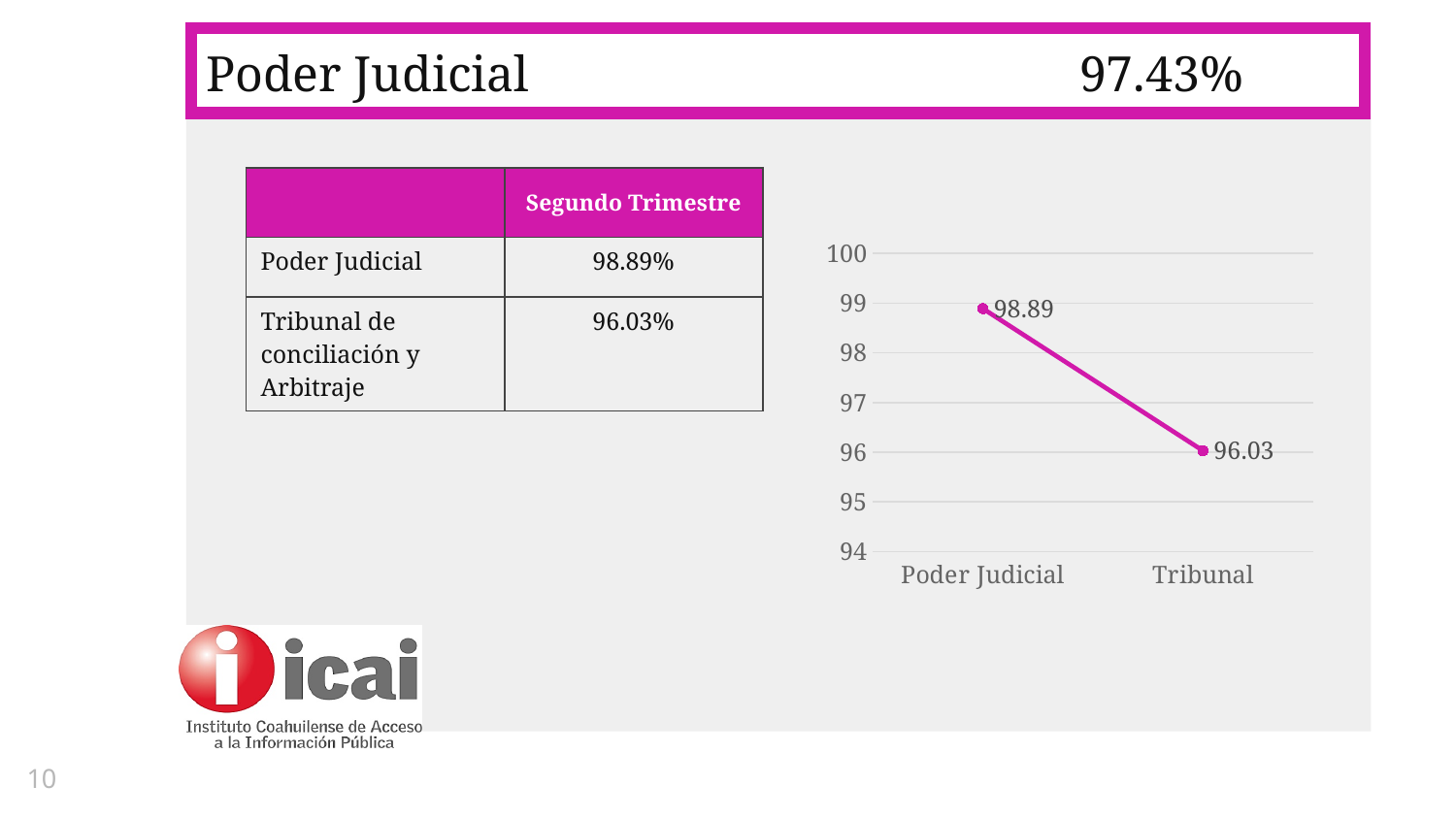
What is the value for Tribunal in the chart? 96.03 What is the value for Poder Judicial in the chart? 98.89 Is the value for Poder Judicial greater or less than 98? greater What is the lowest value shown on the chart's y axis? 94 Which category has the lowest value in the chart? Tribunal Which is larger, the value for Poder Judicial or the value for Tribunal? Poder Judicial What kind of chart is shown on the slide? line chart How many categories are plotted on the x axis of the chart? 2 Which category has the highest value in the chart? Poder Judicial Do the values rise or fall from Poder Judicial to Tribunal along the x axis? fall Is the value for Tribunal greater or less than 97? less What is the difference between the values for Poder Judicial and Tribunal? 2.86